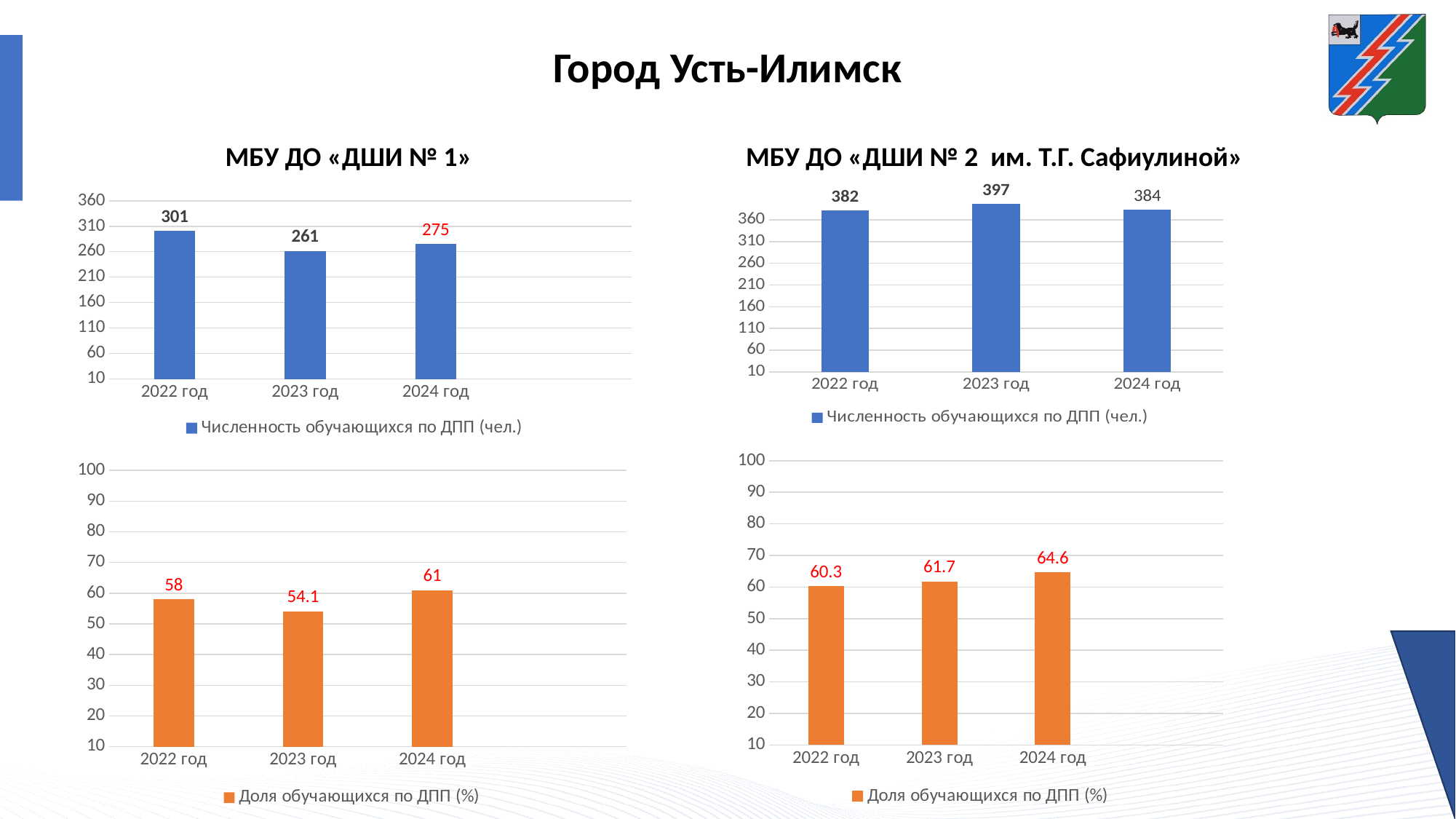
In the top-left chart under «МБУ ДО «ДШИ № 1»» (Численность обучающихся по ДПП), which year has the lowest value? 2023 год In the top-right chart under «МБУ ДО «ДШИ № 2 им. Т.Г. Сафиулиной»» (Численность обучающихся по ДПП), what is the value for 2023 год? 397 In the top-left chart under «МБУ ДО «ДШИ № 1»» (Численность обучающихся по ДПП), what is the value for 2022 год? 301 In the bottom-left chart under «МБУ ДО «ДШИ № 1»» (Доля обучающихся по ДПП), which is larger: the value for 2022 год or 2024 год? 2024 год In the top-right chart under «МБУ ДО «ДШИ № 2 им. Т.Г. Сафиулиной»» (Численность обучающихся по ДПП), which year has the highest value? 2023 год In the bottom-left chart under «МБУ ДО «ДШИ № 1»» (Доля обучающихся по ДПП), what is the value for 2023 год? 54.1 In the bottom-right chart under «МБУ ДО «ДШИ № 2 им. Т.Г. Сафиулиной»» (Доля обучающихся по ДПП), what is the value for 2024 год? 64.6 In the bottom-right chart under «МБУ ДО «ДШИ № 2 им. Т.Г. Сафиулиной»» (Доля обучающихся по ДПП), do the values rise or fall from 2022 год to 2024 год? rise In the top-right chart under «МБУ ДО «ДШИ № 2 им. Т.Г. Сафиулиной»» (Численность обучающихся по ДПП), what is the difference between the 2023 год and 2022 год values? 15 In the top-left chart under «МБУ ДО «ДШИ № 1»» (Численность обучающихся по ДПП), what is the difference between the 2022 год and 2024 год values? 26 What kind of chart is the top-left chart under «МБУ ДО «ДШИ № 1»» (Численность обучающихся по ДПП)? bar chart How many categories (years) are shown in the bottom-right chart under «МБУ ДО «ДШИ № 2 им. Т.Г. Сафиулиной»» (Доля обучающихся по ДПП)? 3